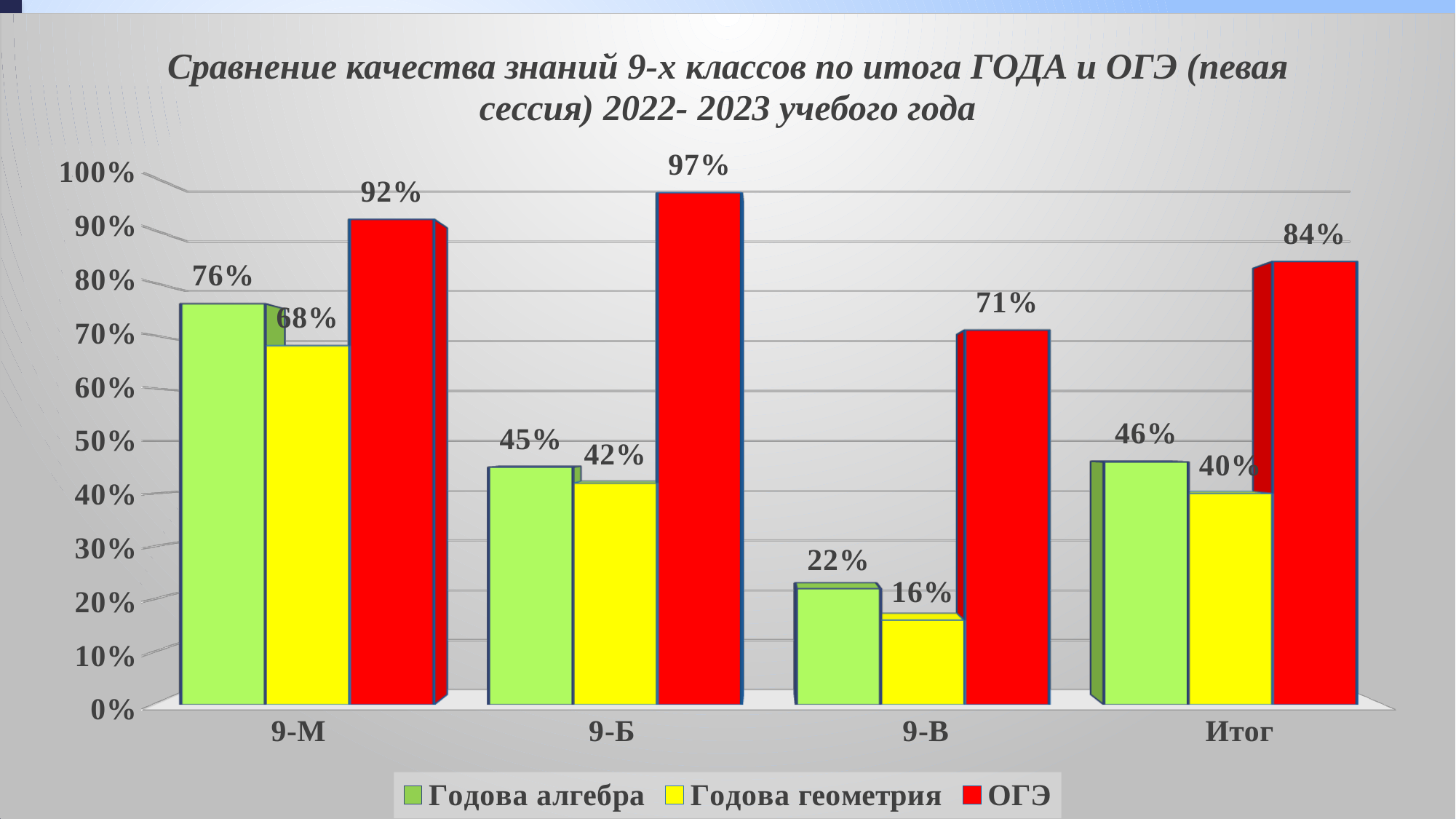
Which is larger for 9-Б: Годова алгебра or Годова геометрия? Годова алгебра What is the ОГЭ value for Итог? 84% What kind of chart is shown on the slide? Bar chart How many categories are shown on the x axis? 4 What is the Годова геометрия value for 9-В? 16% What is the ОГЭ value for 9-Б? 97% What is the Годова алгебра value for 9-М? 76% Which category has the highest ОГЭ value? 9-Б Which series is shown in red in the legend? ОГЭ Which category has the lowest Годова алгебра value? 9-В What is the difference between the ОГЭ value and the Годова алгебра value for 9-В? 49% How many series does the legend list? 3